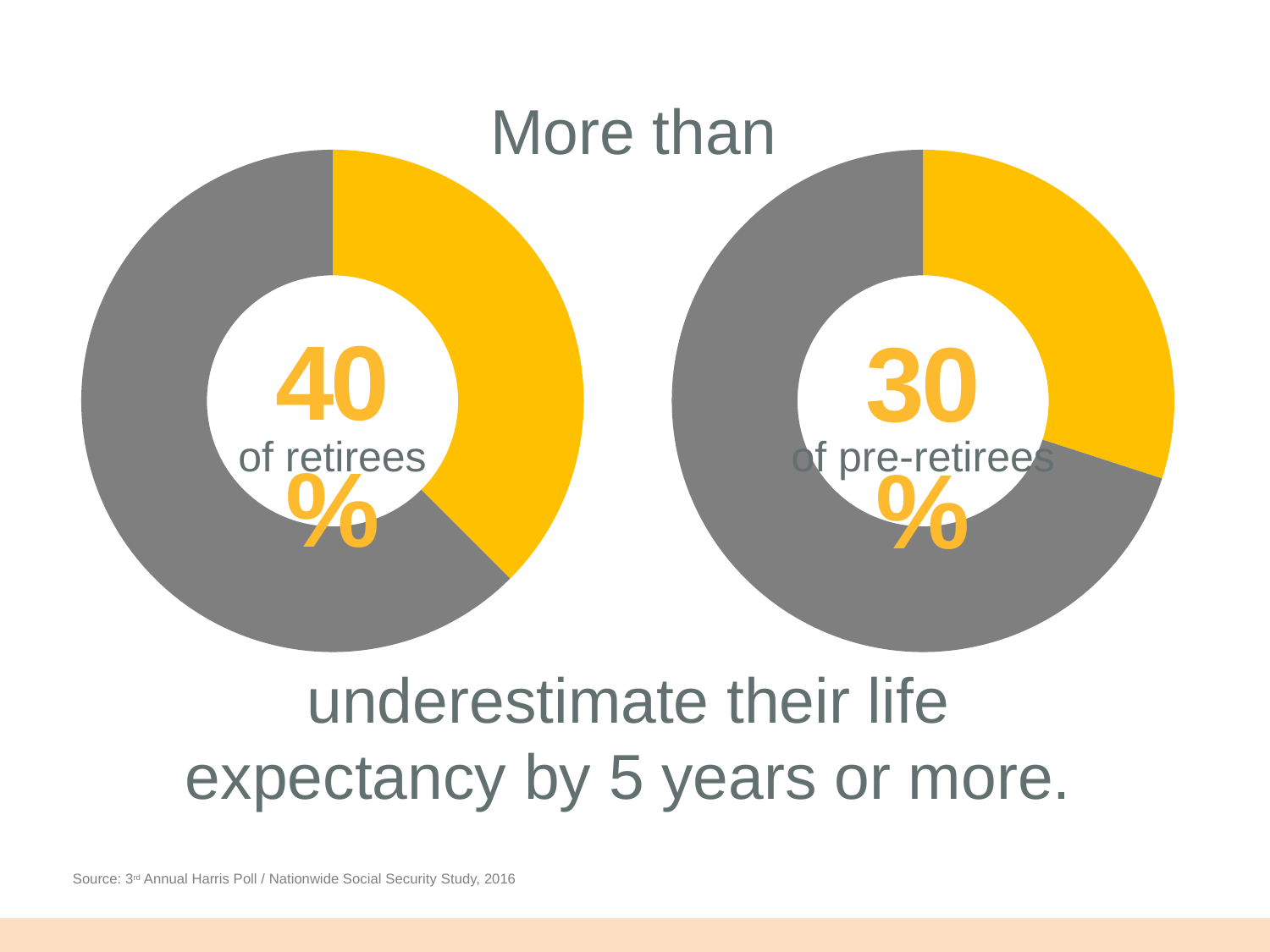
Which group has the higher percentage shown, retirees or pre-retirees? retirees What is the difference in percentage points between the retirees value and the pre-retirees value? 10 On the left chart, what share of the donut does the yellow slice represent? 40% How many slices does the left donut chart have? 2 On the right chart, is the yellow slice greater or less than half of the donut? less Which of the two charts shows the lower percentage? pre-retirees What colour is used for the highlighted slice in both donut charts? yellow How many donut charts are on the slide? 2 On the right chart, what percentage of pre-retirees underestimate their life expectancy by 5 years or more? 30% What source is cited at the bottom of the slide? 3rd Annual Harris Poll / Nationwide Social Security Study, 2016 What kind of chart is used on the left of the slide? donut (pie) chart On the left chart, what percentage of retirees underestimate their life expectancy by 5 years or more? 40%